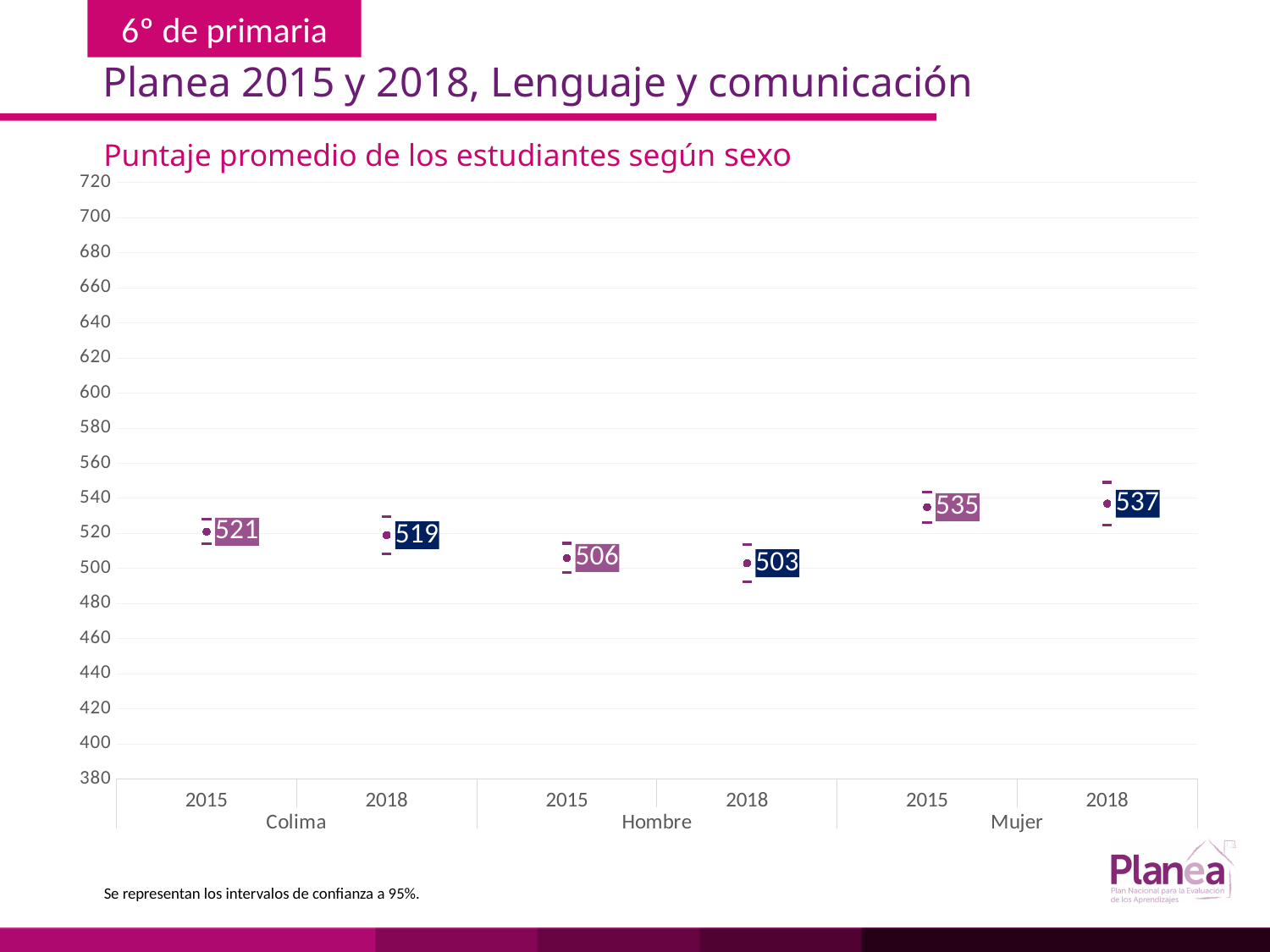
What is the title of the chart? Puntaje promedio de los estudiantes según sexo Did the Hombre score rise or fall from 2015 to 2018? fall How many data points are plotted on the chart? 6 What is the difference between the Mujer 2015 score and the Hombre 2015 score? 29 What is the difference between the Colima 2015 score and the Colima 2018 score? 2 Which group and year has the highest average score? Mujer 2018 What is the average score for Mujer in 2018? 537 What is the average score for Hombre in 2015? 506 Is the value for Mujer 2015 greater or less than 520? greater Which group and year has the lowest average score? Hombre 2018 What is the average score for Colima in 2018? 519 Which is larger, the Hombre 2018 score or the Colima 2018 score? Colima 2018